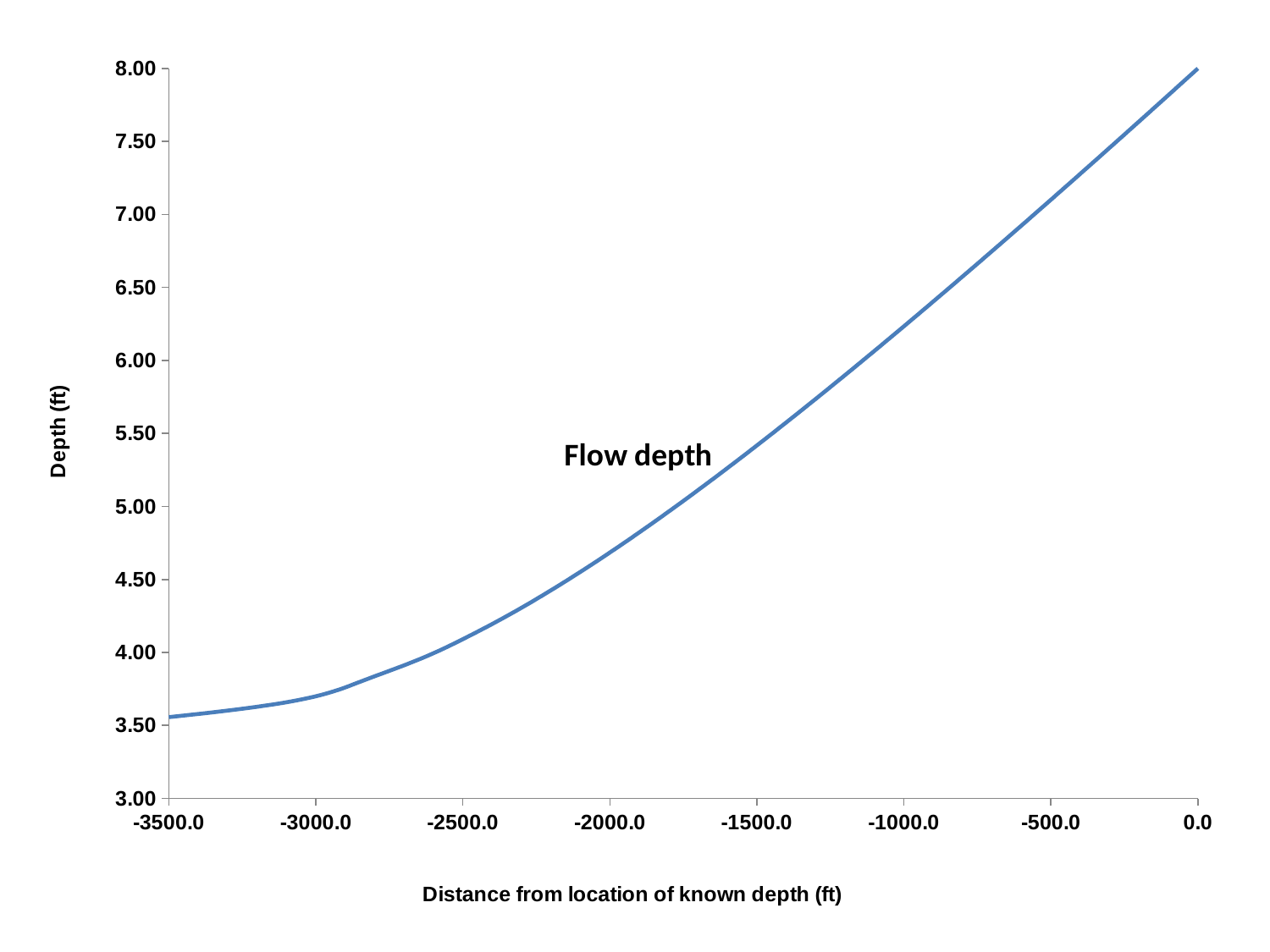
Is the flow depth at a distance of -3000.0 greater or less than 4.00? less At which distance on the x axis is the flow depth lowest? -3500.0 What kind of chart is shown on the slide? line chart Is the flow depth at a distance of -1000.0 greater or less than 6.00? greater Is the flow depth at a distance of -2000.0 greater or less than 4.50? greater What is the label of the plotted line? Flow depth Does the flow depth rise or fall as the distance goes from -3500.0 to 0.0? rise At which distance on the x axis is the flow depth highest? 0.0 What is the title of the x axis? Distance from location of known depth (ft)